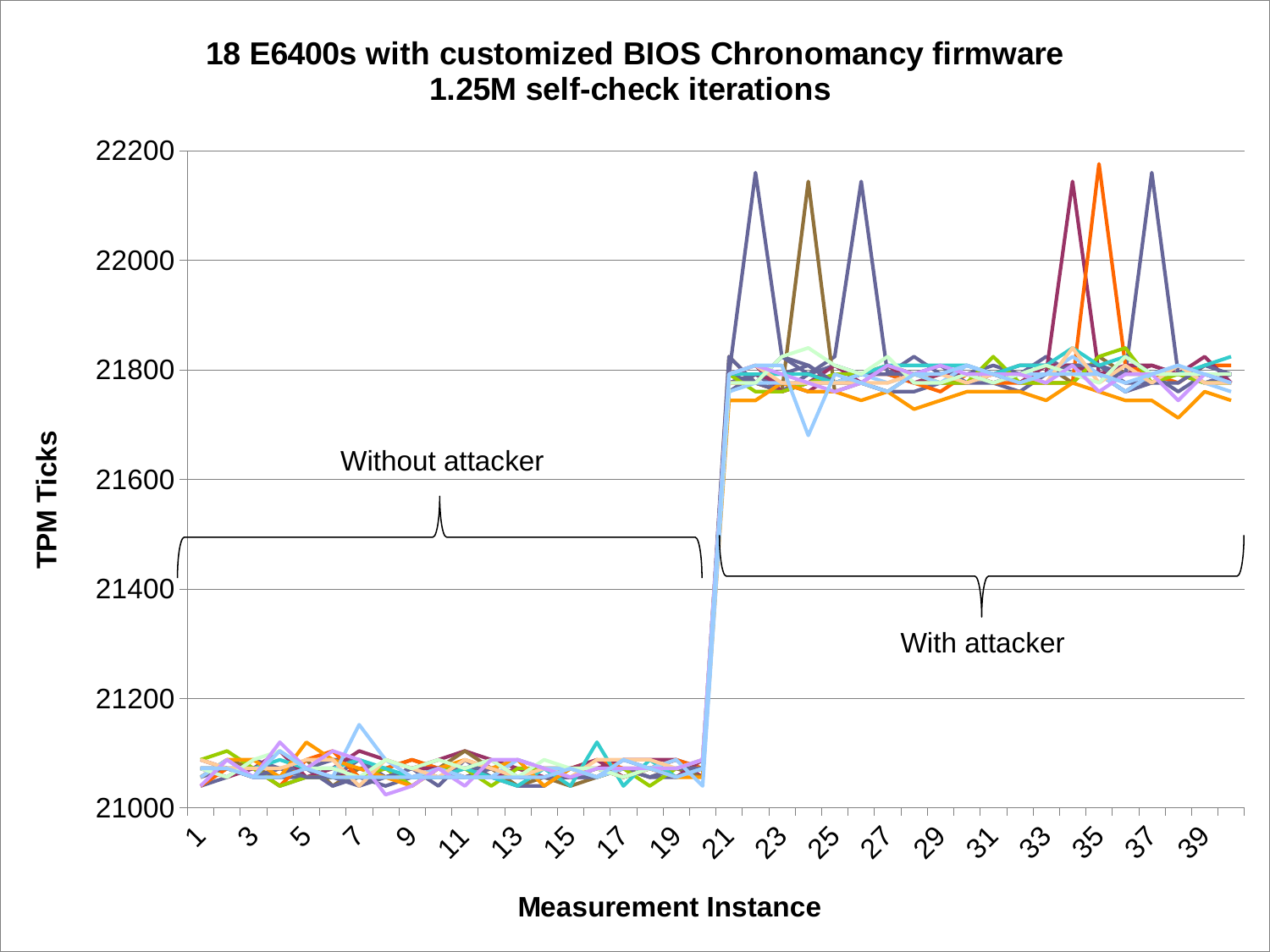
What is the title of the chart? 18 E6400s with customized BIOS Chronomancy firmware 1.25M self-check iterations What kind of chart is shown on the slide? Line chart Are the values at measurement instance 5 greater or less than 21200? less Do the TPM Ticks values rise or fall when moving from measurement instance 20 to measurement instance 21? rise Is the highest spike near measurement instance 22 greater or less than 22000? greater What is the highest value shown on the y axis? 22200 Are the values at measurement instance 30 greater or less than 21600? greater Which region has higher TPM Ticks values, the 'Without attacker' region or the 'With attacker' region? With attacker What is the label of the y axis? TPM Ticks